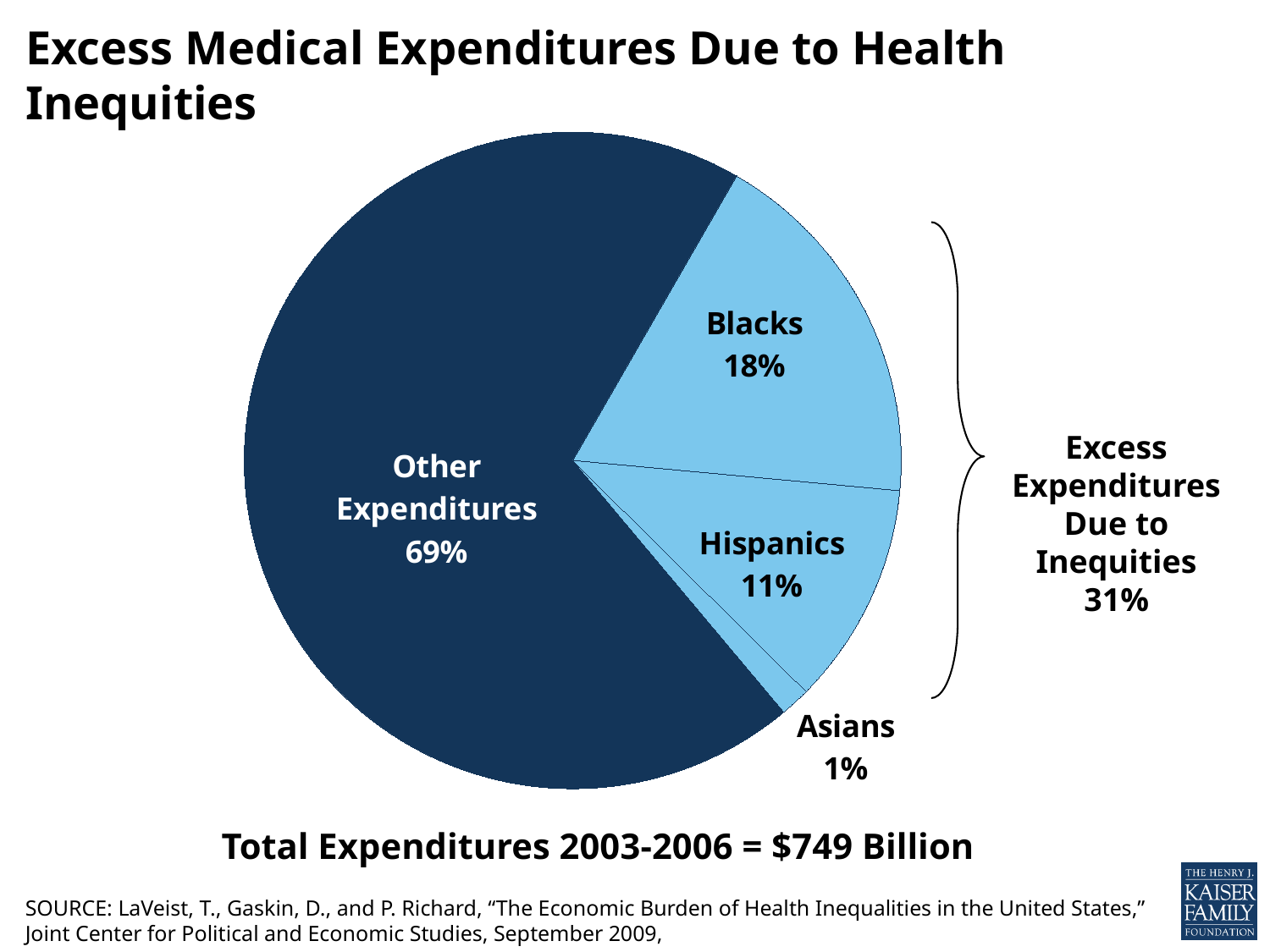
Which is larger, the Hispanics slice or the Asians slice? Hispanics How many slices does the pie chart have? 4 What kind of chart is shown on the slide? Pie chart What is the combined share of excess expenditures due to inequities shown by the bracket? 31% What share of expenditures is attributed to Asians? 1% What total expenditure figure for 2003-2006 is stated below the chart? $749 Billion What share of expenditures is attributed to Blacks? 18% What is the difference in percentage points between the Blacks slice and the Hispanics slice? 7 percentage points What share of expenditures is attributed to Hispanics? 11% Which slice of the pie is the largest? Other Expenditures What share of the pie is labelled Other Expenditures? 69% Which slice of the pie is the smallest? Asians